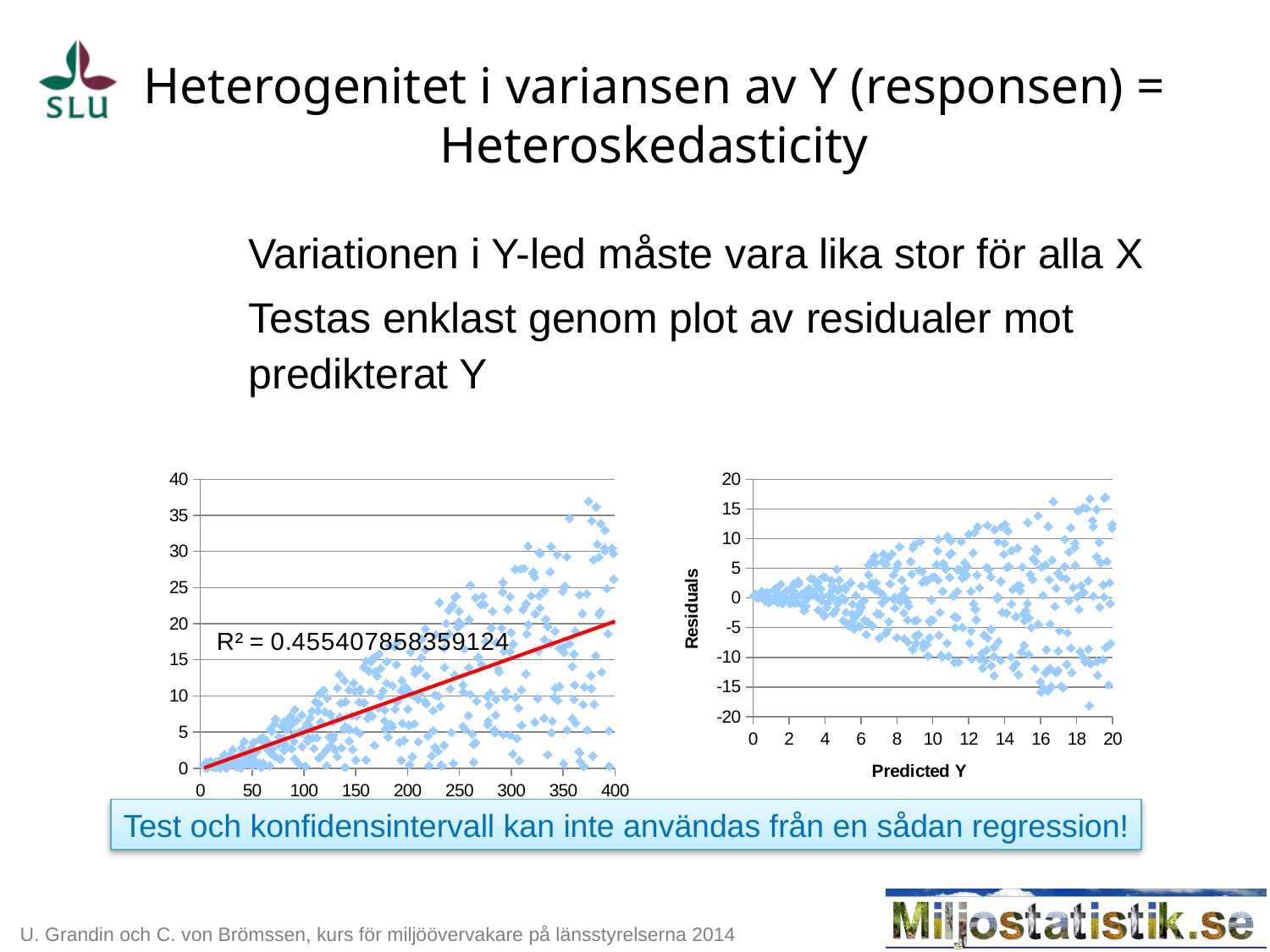
On the right chart, does the spread of the residuals widen or narrow as Predicted Y increases? widen What colour is the trendline on the left chart? red On the right chart, what is the highest value shown on the x axis? 20 On the left chart, what R² value is printed? R² = 0.455407858359124 What kind of chart is the left chart on the slide? scatter chart What kind of chart is the right chart on the slide? scatter chart On the left chart, do the plotted values generally rise or fall as x increases? rise